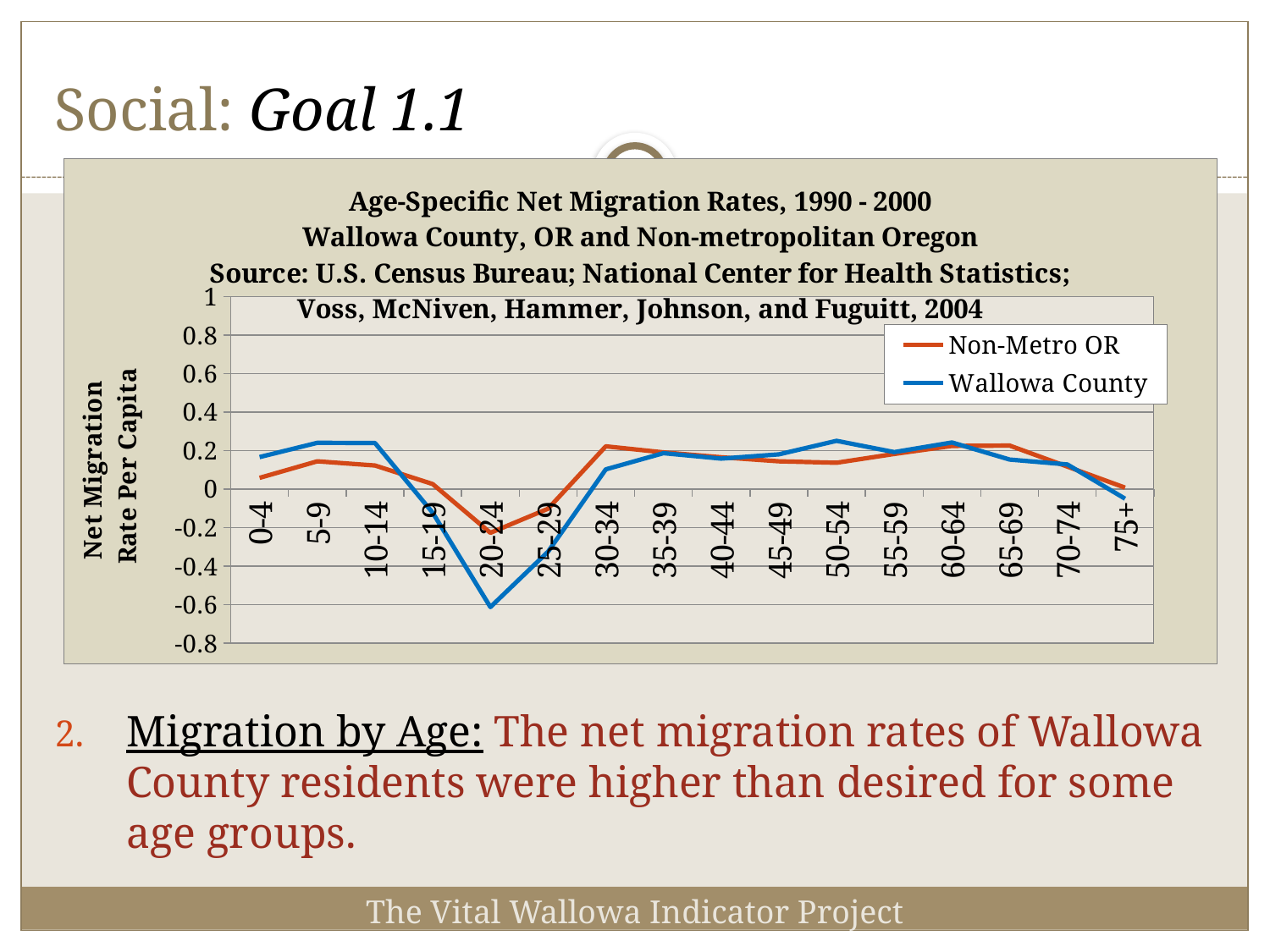
What time period does the chart title say the net migration rates cover? 1990 - 2000 For the 20-24 age group, which series has the lower value, Non-Metro OR or Wallowa County? Wallowa County How many series does the legend list? 2 Is the Non-Metro OR value for the 20-24 age group greater or less than 0? less What kind of chart is shown on the slide? Line chart Is the Wallowa County value for the 50-54 age group greater or less than 0? greater Is the Wallowa County value for the 20-24 age group greater or less than -0.4? less For which age group does the Wallowa County line reach its lowest value? 20-24 How many age groups are shown along the x axis? 16 For the 30-34 age group, which series has the higher value, Non-Metro OR or Wallowa County? Non-Metro OR Which series is drawn with the blue line? Wallowa County